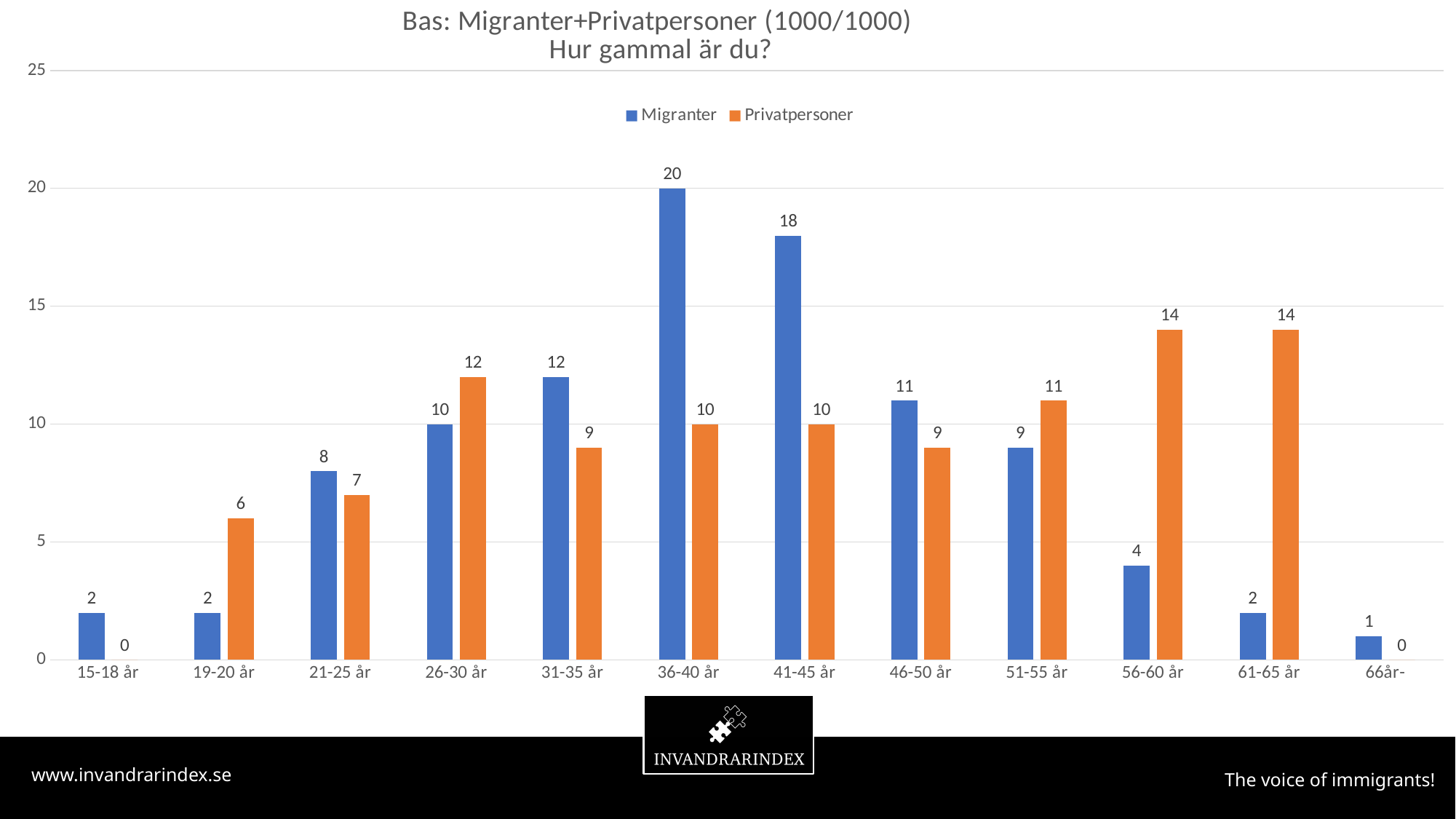
What is the value for Privatpersoner in the 19-20 år category? 6 In the 56-60 år category, which series has the larger value, Migranter or Privatpersoner? Privatpersoner What is the difference between the Privatpersoner values for 56-60 år and 51-55 år? 3 Which age category has the highest value for Migranter? 36-40 år What is the difference between the Migranter and Privatpersoner values in the 41-45 år category? 8 What is the value for Privatpersoner in the 61-65 år category? 14 What colour are the bars for the Privatpersoner series? Orange Which age category has the lowest value for Privatpersoner? 15-18 år and 66år- (both 0) What kind of chart is shown on the slide? Bar chart What is the value for Migranter in the 36-40 år category? 20 How many series does the legend list? 2 How many age categories are shown on the x axis? 12